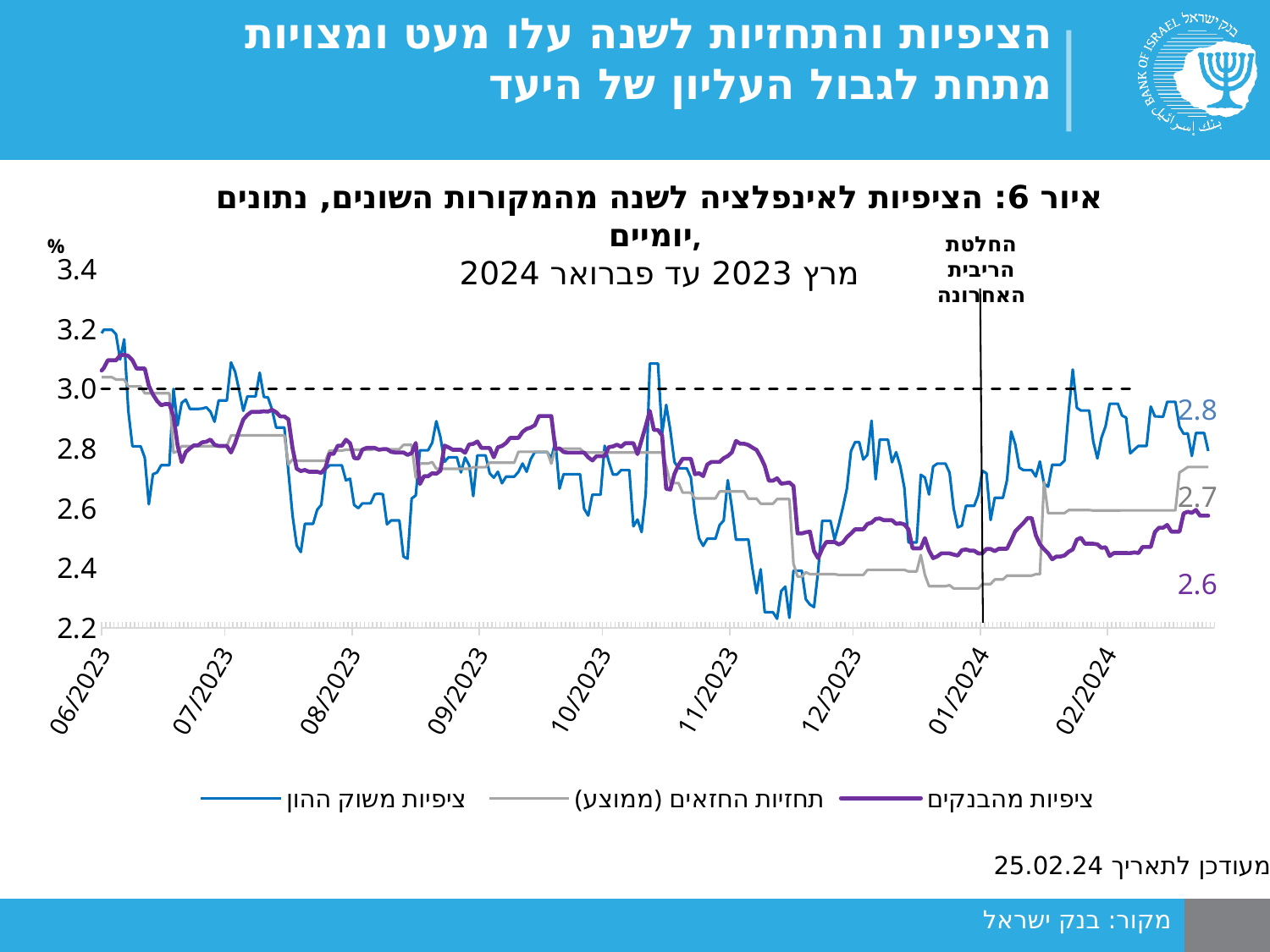
Which series has the highest labelled end value: ציפיות משוק ההון or ציפיות מהבנקים? ציפיות משוק ההון Is the value of the ציפיות מהבנקים series at 06/2023 greater or less than 3.0? greater What is the latest labelled value of the ציפיות מהבנקים series? 2.6 What is the difference between the labelled end values of ציפיות משוק ההון and ציפיות מהבנקים? 0.2 How many month labels are shown on the x axis? 9 At what value is the horizontal dashed line drawn? 3.0 Is the value of the תחזיות החזאים (ממוצע) series at 12/2023 greater or less than 2.6? less What does the label on the vertical line near 01/2024 say? החלטת הריבית האחרונה What is the latest labelled value of the תחזיות החזאים (ממוצע) series? 2.7 What kind of chart is shown on the slide? line chart What is the latest labelled value of the ציפיות משוק ההון series? 2.8 How many series does the legend list? 3